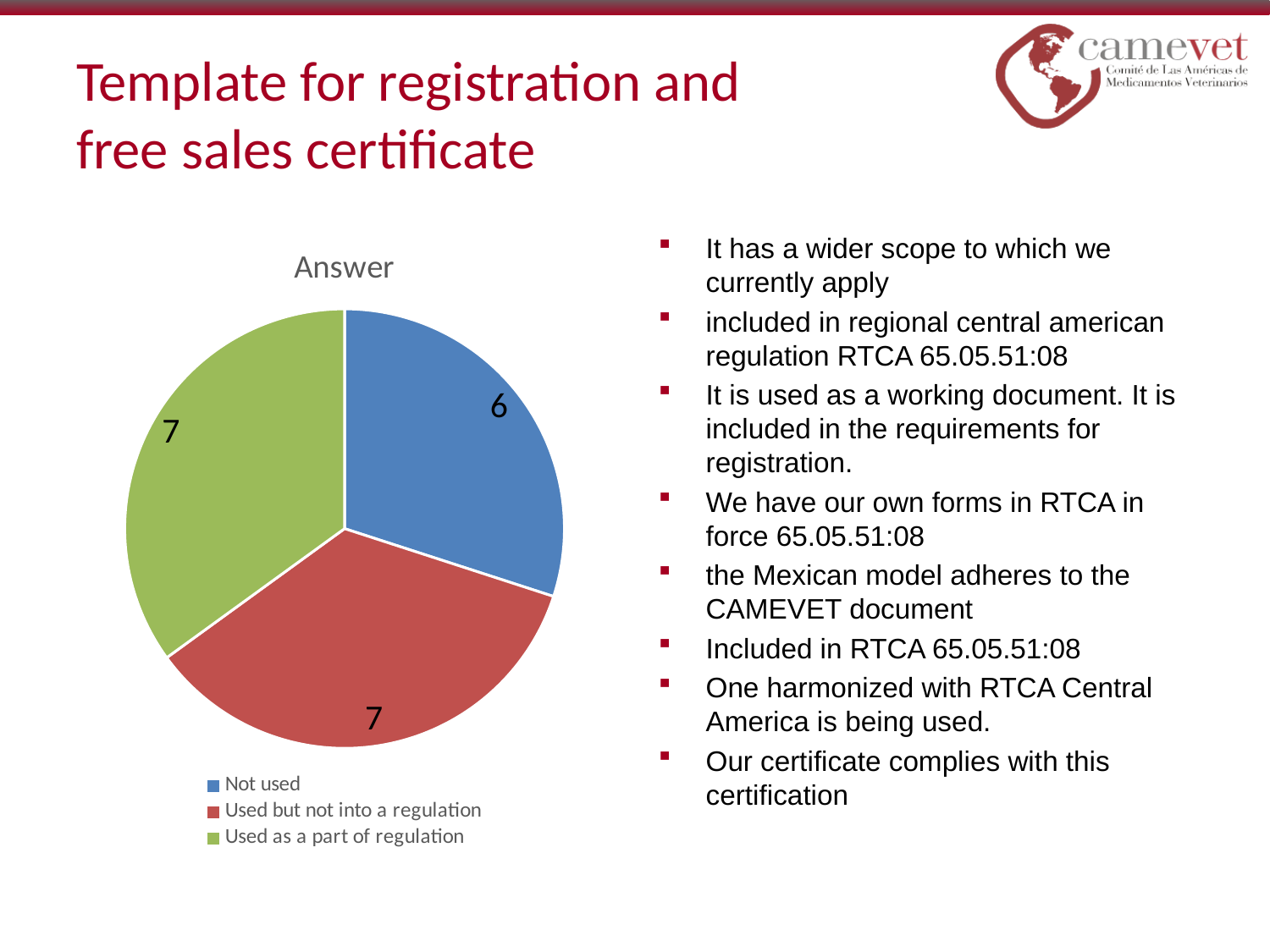
Which colour represents 'Used as a part of regulation' in the pie chart? green What is the value for the 'Used as a part of regulation' slice? 7 What is the total of all slices in the pie chart? 20 What share of the pie does the 'Not used' slice represent? 30% What is the difference between the values for 'Used as a part of regulation' and 'Not used'? 1 What is the title of the chart? Answer Which category has the lowest value in the pie chart? Not used What is the value for the 'Not used' slice? 6 What kind of chart is shown on the slide? pie chart What is the value for the 'Used but not into a regulation' slice? 7 How many categories does the pie chart have? 3 Which is larger, the value for 'Not used' or the value for 'Used but not into a regulation'? Used but not into a regulation